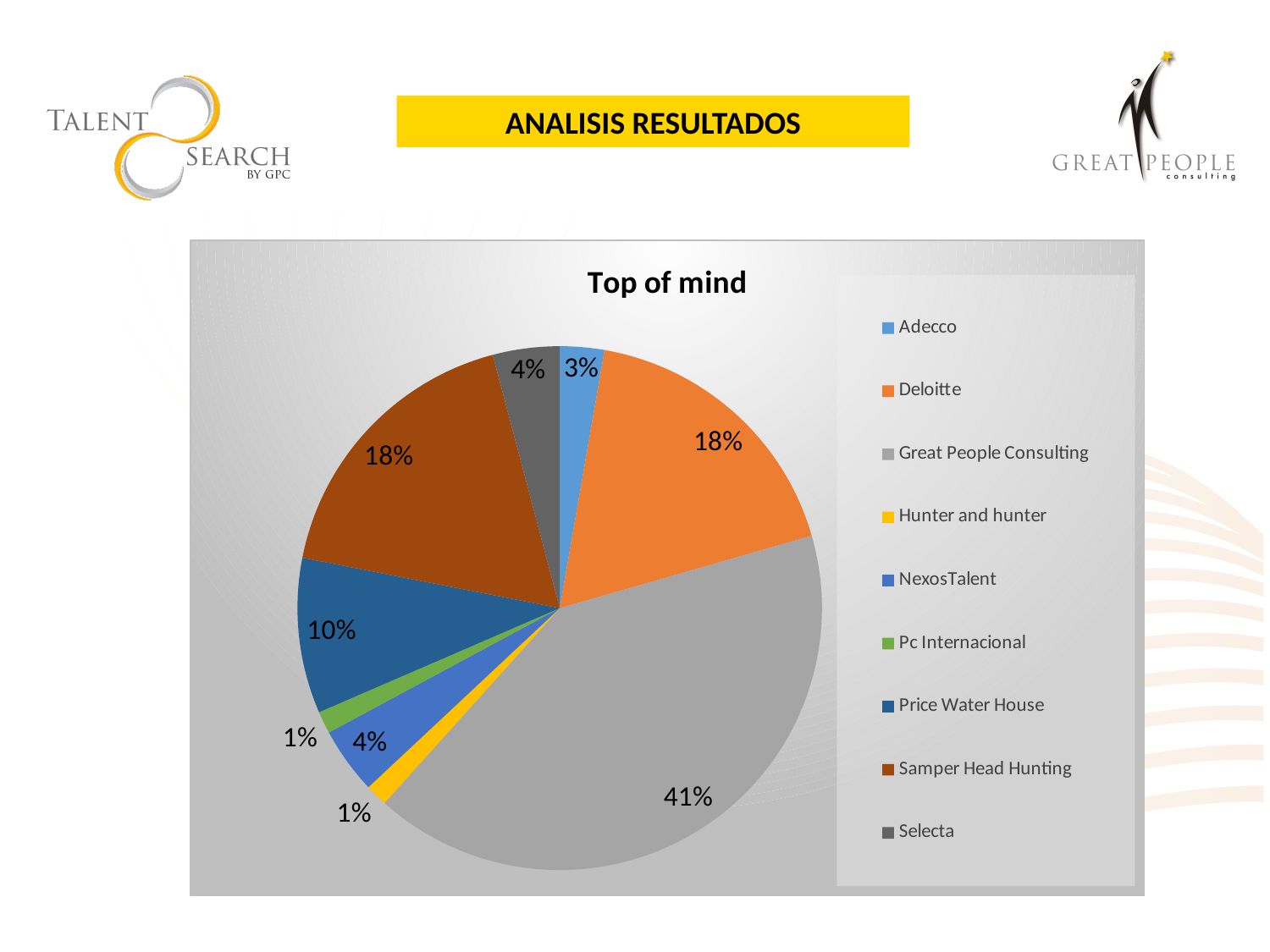
What share of the pie does Selecta have? 4% Which has a larger share, Price Water House or NexosTalent? Price Water House What kind of chart is shown on the slide? pie chart What is the difference between the shares of Great People Consulting and Samper Head Hunting? 23% What is the title of the chart? Top of mind What share of the pie does Great People Consulting have? 41% What share of the pie does Deloitte have? 18% Which category has the largest slice of the pie? Great People Consulting How many categories does the legend of the pie chart list? 9 What is the difference between the shares of Price Water House and Adecco? 7%